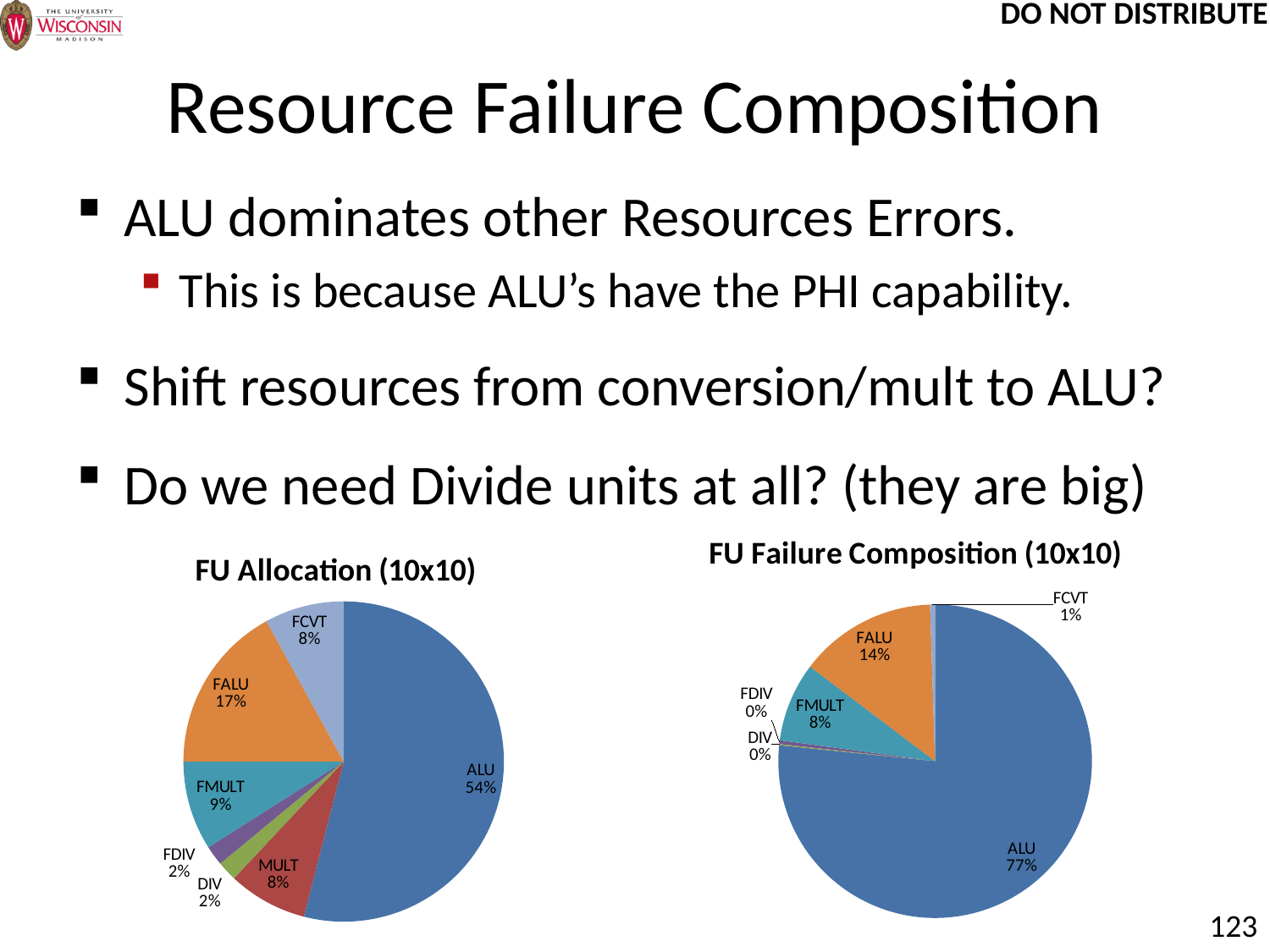
In the FU Failure Composition (10x10) chart, what is the percentage for FCVT? 1% In the FU Allocation (10x10) chart, which is larger, the FMULT share or the MULT share? FMULT In the FU Allocation (10x10) chart, what is the difference between the ALU share and the FALU share? 37% What type of chart is the FU Failure Composition (10x10) chart? Pie chart In the FU Allocation (10x10) chart, what is the percentage for FALU? 17% In the FU Failure Composition (10x10) chart, what share does ALU have? 77% In the FU Allocation (10x10) chart, which category has the largest slice? ALU In the FU Failure Composition (10x10) chart, what is the difference between the FALU share and the FMULT share? 6% How many labeled categories are shown in the FU Allocation (10x10) chart? 7 In the FU Failure Composition (10x10) chart, what is the percentage for FMULT? 8% In the FU Allocation (10x10) chart, what share does ALU have? 54% In the FU Failure Composition (10x10) chart, which category has the largest slice? ALU